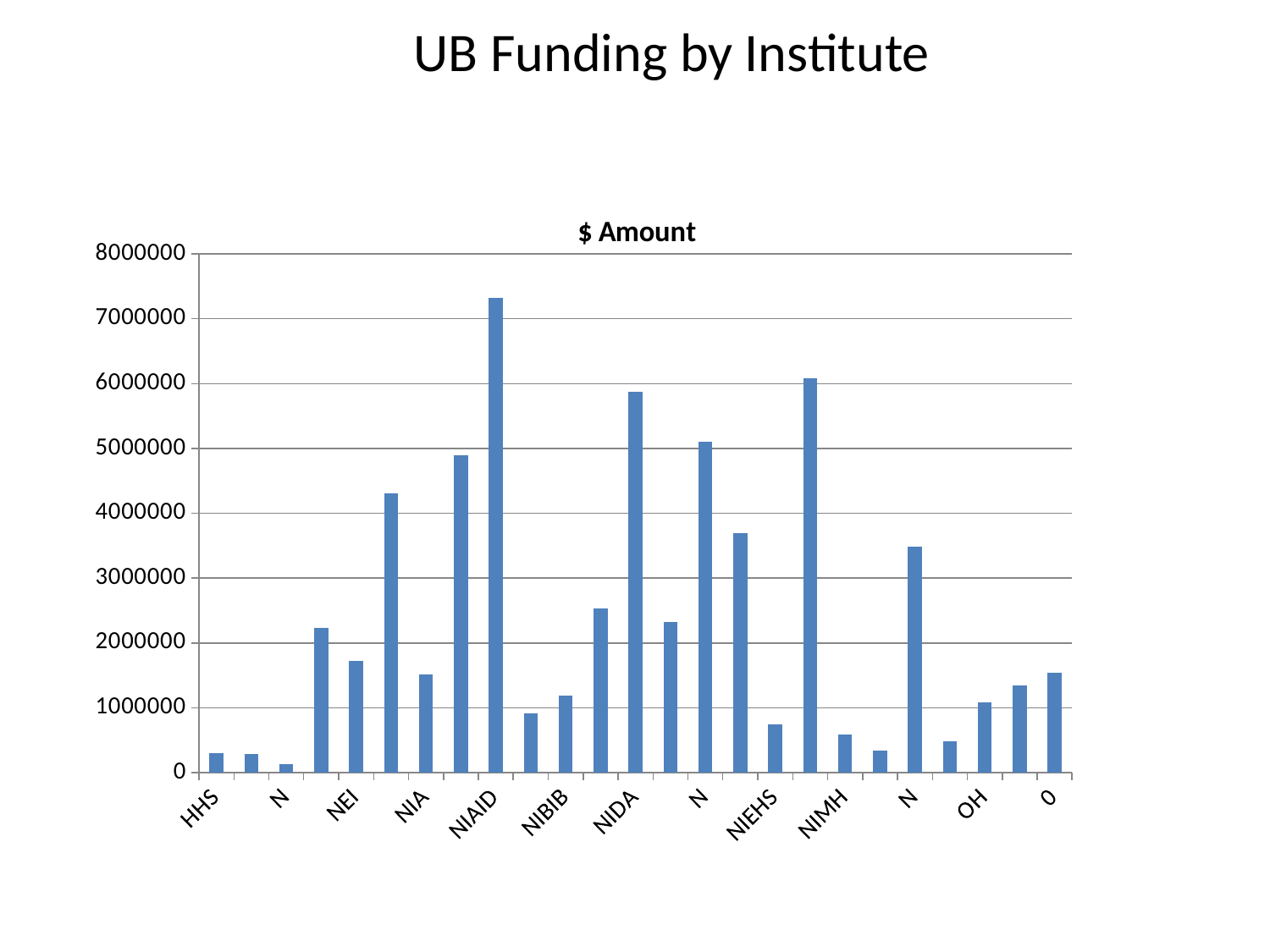
What is the title shown above the plot area of the chart? $ Amount Which has a larger funding amount, NEI or NIA? NEI Is the value for OH greater or less than 1000000? greater Which has a larger funding amount, NIAID or NIDA? NIAID Is the value for NEI greater or less than 2000000? less Which institute has the highest funding amount in the chart? NIAID Is the value for HHS greater or less than 1000000? less How many bars are plotted in the chart? 25 What kind of chart is shown on the slide? bar chart